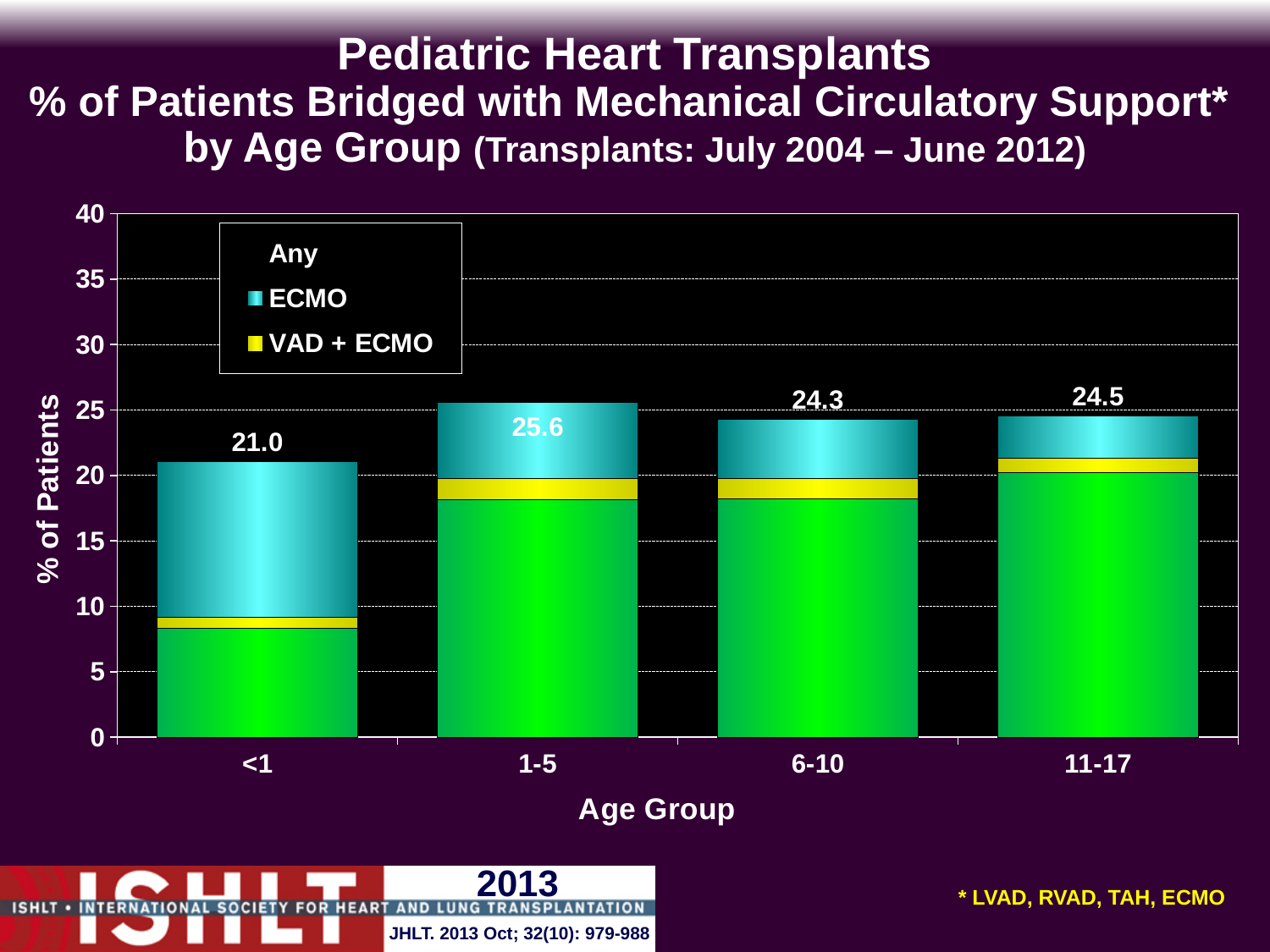
How many age groups are shown on the x axis? 4 What is the total percentage of patients bridged with mechanical circulatory support for the <1 age group? 21.0 Is the green (bottom) segment of the <1 age group bar greater or less than 10? less How many series does the legend list? 3 What kind of chart is shown on the slide? Stacked bar chart What is the total percentage shown above the bar for the 1-5 age group? 25.6 What is the difference between the total percentages for the 1-5 and <1 age groups? 4.6 Which age group has the highest total percentage of patients bridged with mechanical circulatory support? 1-5 Which age group has a larger total percentage, 6-10 or 11-17? 11-17 Which age group has the lowest total percentage of patients bridged with mechanical circulatory support? <1 What is the total percentage shown for the 11-17 age group? 24.5 What is the total percentage shown for the 6-10 age group? 24.3